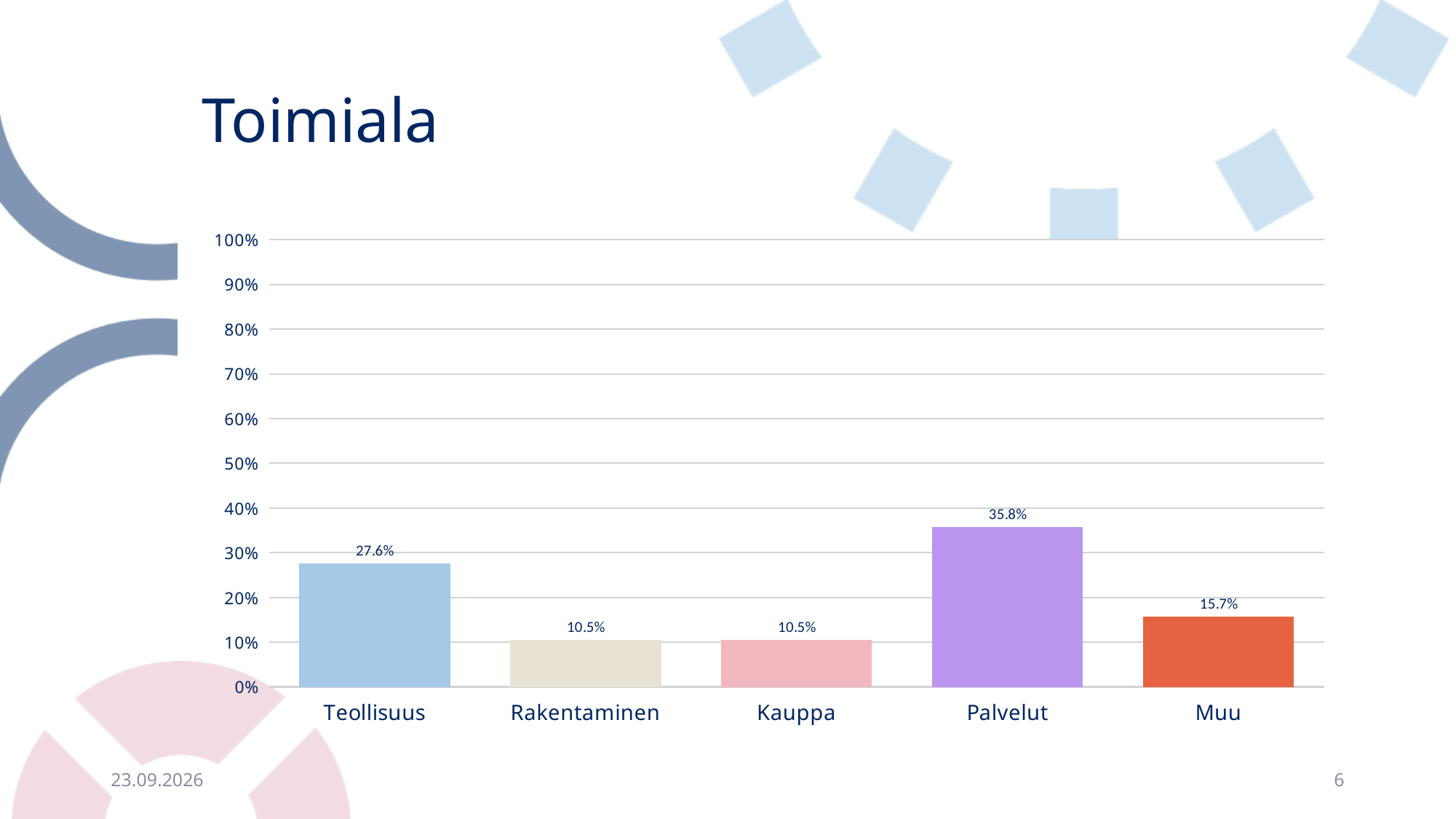
What is the value for Palvelut? 35.8% What is the difference between the values for Teollisuus and Muu? 11.9% What is the value for Teollisuus? 27.6% Which is larger, the value for Muu or the value for Kauppa? Muu Which category has the highest value? Palvelut What is the value for Muu? 15.7% What is the difference between the values for Palvelut and Teollisuus? 8.2% What kind of chart is shown on the slide? Bar chart What is the title of the slide? Toimiala Is the value for Palvelut greater or less than 30%? greater What is the value for Rakentaminen? 10.5% How many categories are shown on the x axis? 5